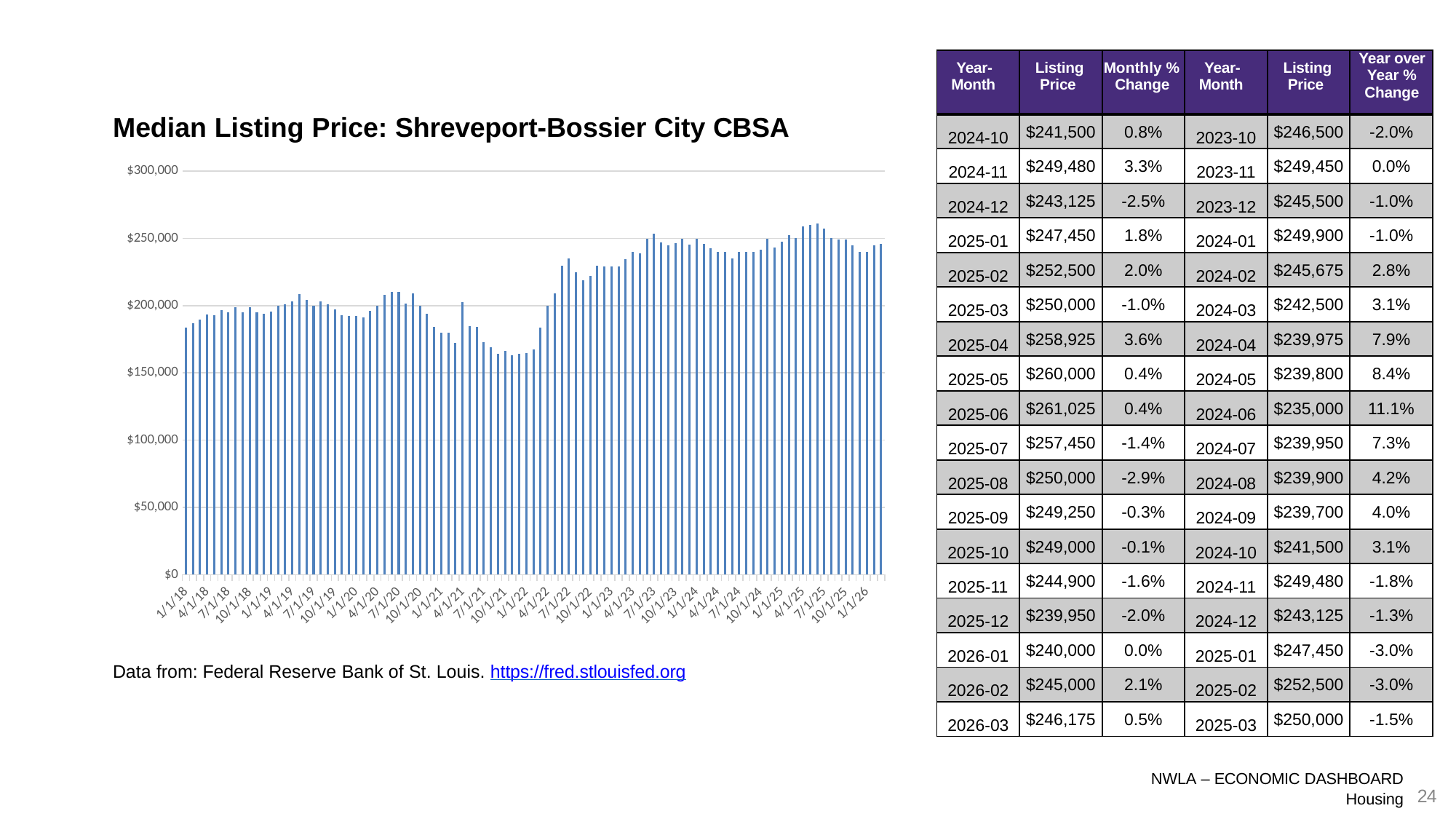
Is the value for 4/1/23 greater or less than $200,000? greater Is the value for 1/1/22 greater or less than $200,000? less What is the title of the chart? Median Listing Price: Shreveport-Bossier City CBSA Which is larger, the value for 7/1/20 or the value for 1/1/22? 7/1/20 Which is larger, the value for 1/1/18 or the value for 1/1/26? 1/1/26 Is the value for 7/1/25 greater or less than $250,000? greater Do the values generally rise or fall between 1/1/22 and 7/1/22? rise Do the values generally rise or fall between 7/1/20 and 1/1/22? fall What kind of chart is shown on the slide? bar chart What is the highest value shown on the chart's vertical axis? $300,000